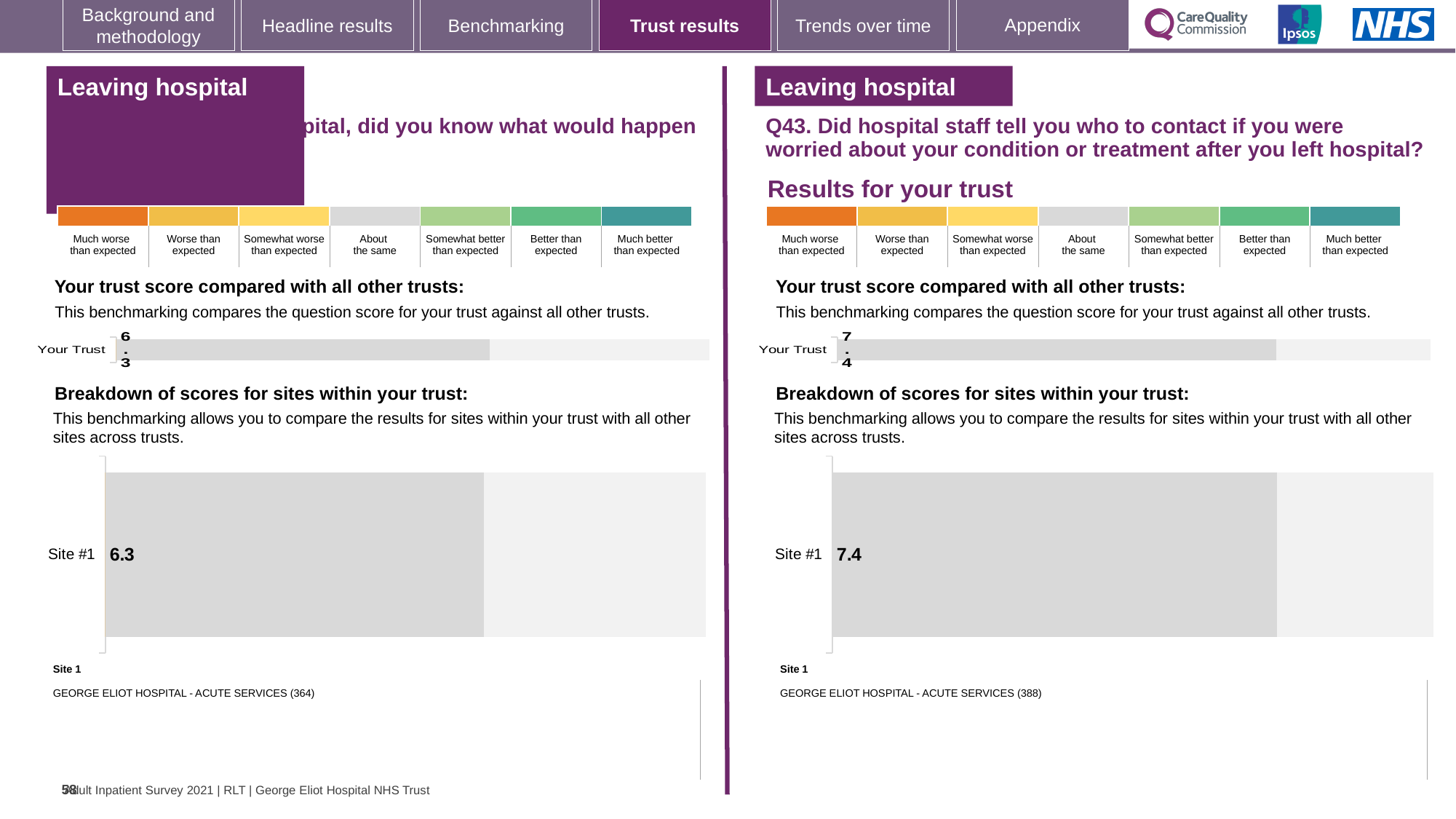
What kind of chart is used to show the Site #1 score on the right-hand side of the slide? Bar chart How many sites are shown in the left-hand 'Breakdown of scores for sites within your trust' chart? 1 Which is larger: the Site #1 score in the left-hand breakdown chart or the Site #1 score in the right-hand breakdown chart (Q43)? The right-hand chart (Q43) How many categories does the colour scale above the left-hand 'Your trust score' chart show, from 'Much worse than expected' to 'Much better than expected'? 7 What is the name of the site labelled Site 1 beneath the right-hand breakdown chart (Q43)? GEORGE ELIOT HOSPITAL - ACUTE SERVICES (388) What is the difference between the Site #1 score in the right-hand breakdown chart (Q43) and the Site #1 score in the left-hand breakdown chart? 1.1 In the right-hand 'Breakdown of scores for sites within your trust' chart (Q43), what is the score for Site #1? 7.4 In the left-hand 'Breakdown of scores for sites within your trust' chart, what is the score for Site #1? 6.3 On the left-hand side of the slide, what is the score shown for Your Trust in the 'Your trust score compared with all other trusts' chart? 6.3 Is the Your Trust score in the right-hand chart (Q43) greater or less than the Your Trust score in the left-hand chart? greater How many sites are shown in the right-hand 'Breakdown of scores for sites within your trust' chart? 1 On the right-hand side of the slide (Q43), what is the score shown for Your Trust in the 'Your trust score compared with all other trusts' chart? 7.4